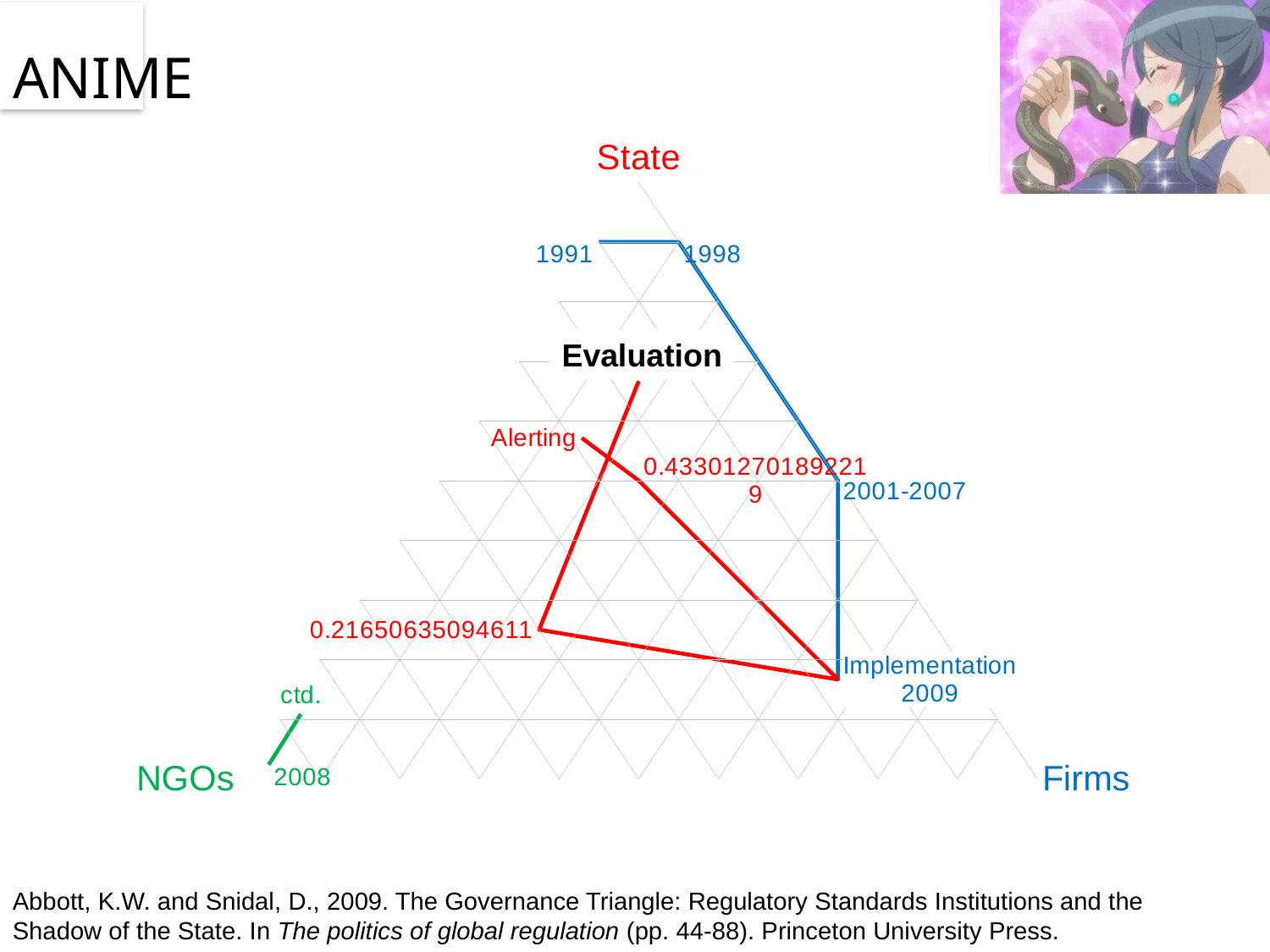
Which year label is shown in green near the NGOs corner? 2008 Which year label appears at the bottom-right end of the blue path, next to 'Implementation'? 2009 What kind of chart is shown on the slide? Triangle (ternary) diagram Which corner of the triangle is labelled in red at the top? State What numeric value is printed in red next to the left vertex of the red triangle? 0.21650635094611 Which year label sits immediately to the right of 1991 on the blue path? 1998 What are the three corner labels of the triangle diagram? State, NGOs, Firms How many year labels (including the range) are placed along the blue path? 4 Which corner of the triangle is labelled in blue? Firms Which year range is labelled on the blue path on the right side of the triangle? 2001-2007 What is the earliest year labelled on the blue path? 1991